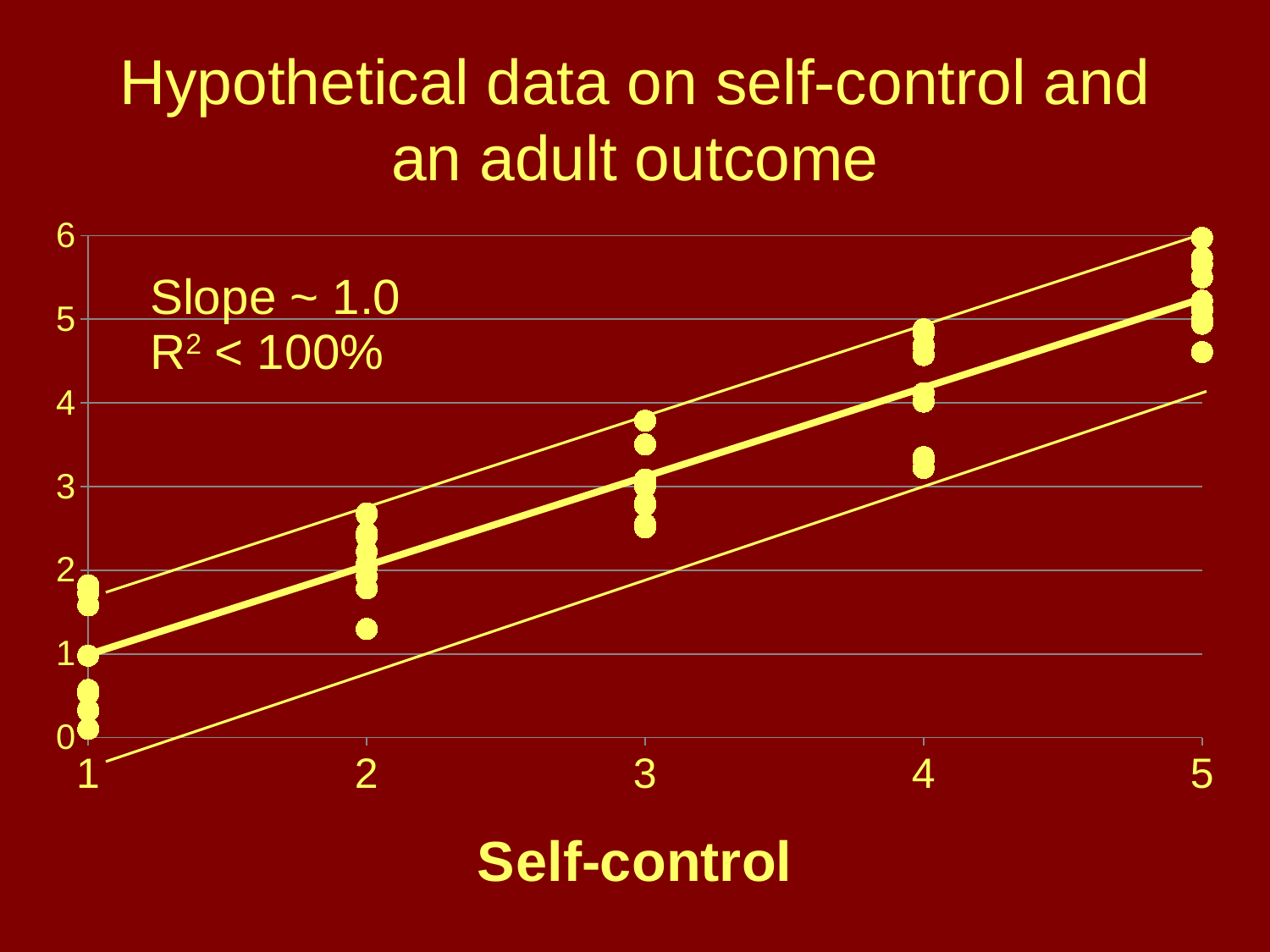
What is the label of the x axis? Self-control What kind of chart is shown on the slide? scatter plot Are the plotted points at self-control 2 greater or less than 3? less As self-control increases along the x axis, do the plotted outcome values rise or fall? rise Are the plotted points at self-control 1 greater or less than 2? less Are the plotted points at self-control 3 greater or less than 2? greater Which self-control value has the highest plotted outcome points? 5 Which self-control value has the lowest plotted outcome points? 1 Which has higher plotted outcome values, self-control 4 or self-control 2? self-control 4 How many self-control values are marked on the x axis? 5 What slope value is annotated on the chart? Slope ~ 1.0